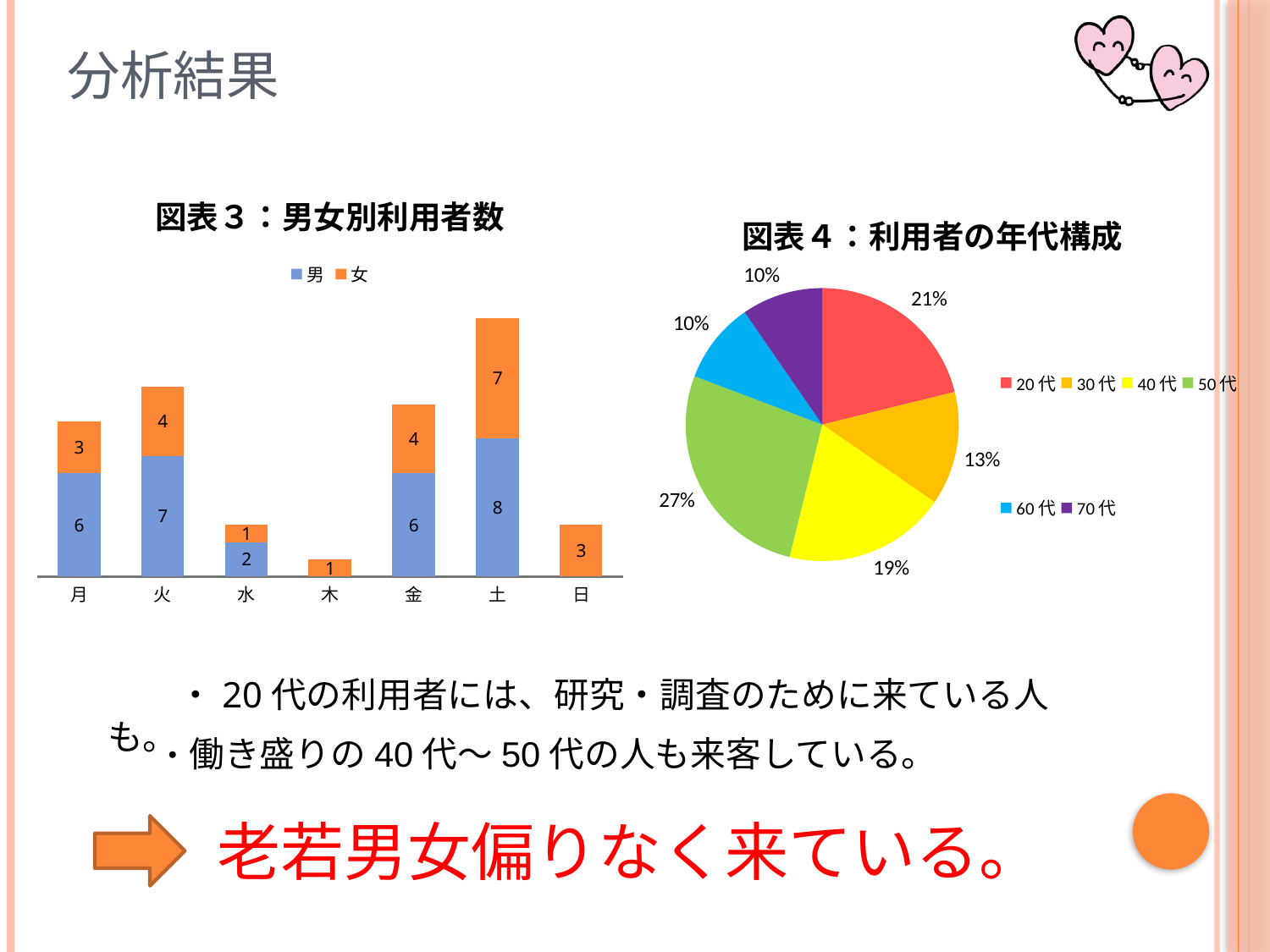
In 図表４：利用者の年代構成, what share does 50代 have? 27% In 図表３：男女別利用者数, what is the total of the stacked bar for 月? 9 In 図表３：男女別利用者数, which day has the shortest stacked bar? 木 In 図表４：利用者の年代構成, which age group has the largest slice? 50代 In 図表３：男女別利用者数, what is the value for 女 on 火? 4 In 図表３：男女別利用者数, what is the total of the stacked bar for 土? 15 In 図表３：男女別利用者数, what is the difference between the 男 values for 土 and 水? 6 In 図表３：男女別利用者数, how many categories are on the x axis? 7 In 図表３：男女別利用者数, how many series does the legend list? 2 In 図表３：男女別利用者数, which day has the tallest stacked bar? 土 In 図表３：男女別利用者数, what is the value for 男 on 土? 8 What kind of chart is 図表４：利用者の年代構成? Pie chart